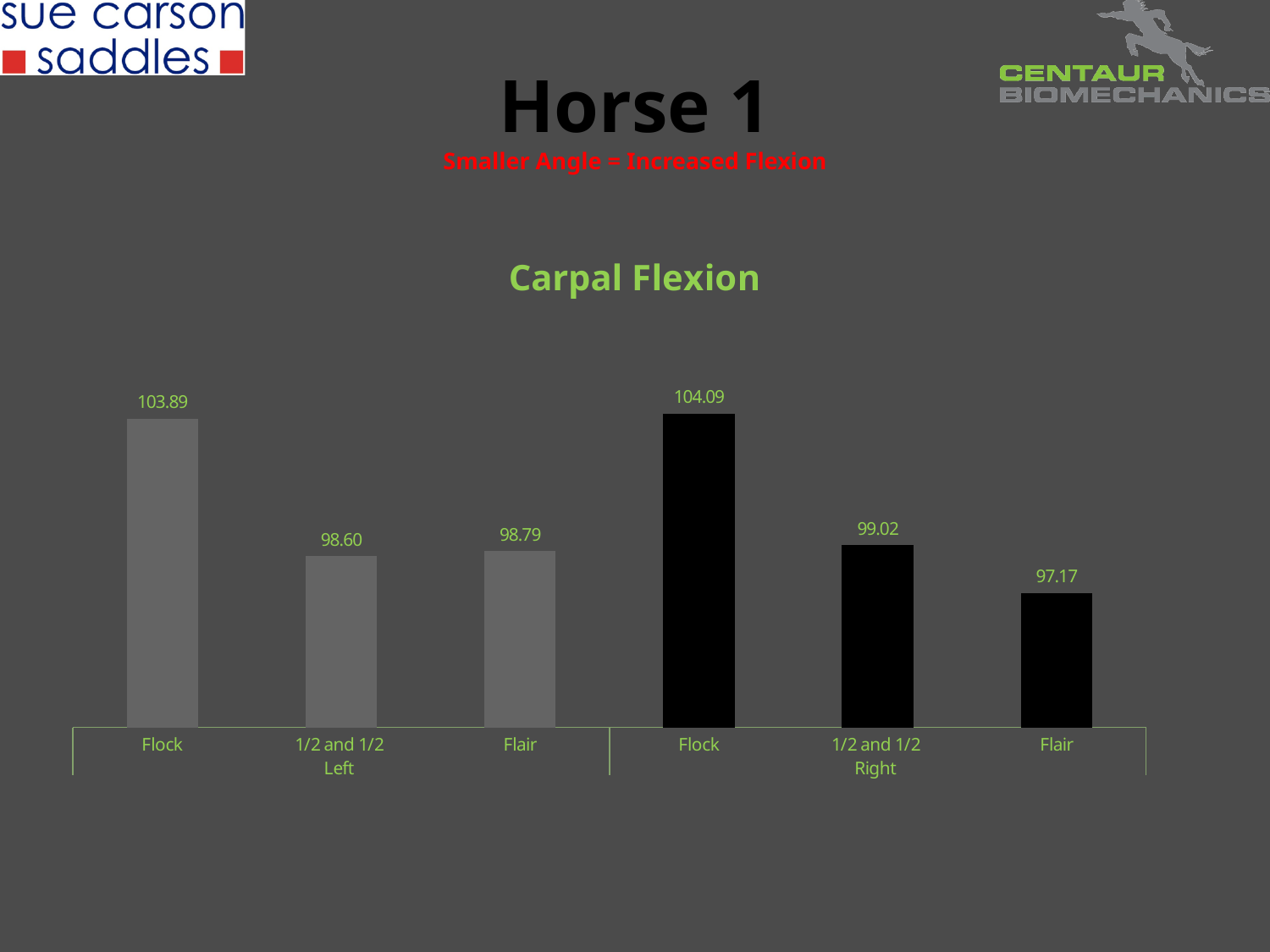
Which bar has the highest Carpal Flexion value? Flock (Right) What is the Carpal Flexion value for 1/2 and 1/2 on the Left side? 98.60 What is the Carpal Flexion value for 1/2 and 1/2 on the Right side? 99.02 How many bars are plotted in the Carpal Flexion chart? 6 What is the difference between the Flock value and the 1/2 and 1/2 value on the Right side? 5.07 What is the difference between the Flock value and the Flair value on the Left side? 5.10 What is the title of the chart? Carpal Flexion What is the Carpal Flexion value for Flock on the Left side? 103.89 Which bar has the lowest Carpal Flexion value? Flair (Right) Which is larger, the Flair value on the Left side or the Flair value on the Right side? Flair (Left) What is the Carpal Flexion value for Flair on the Right side? 97.17 What kind of chart is shown on the slide? Bar chart